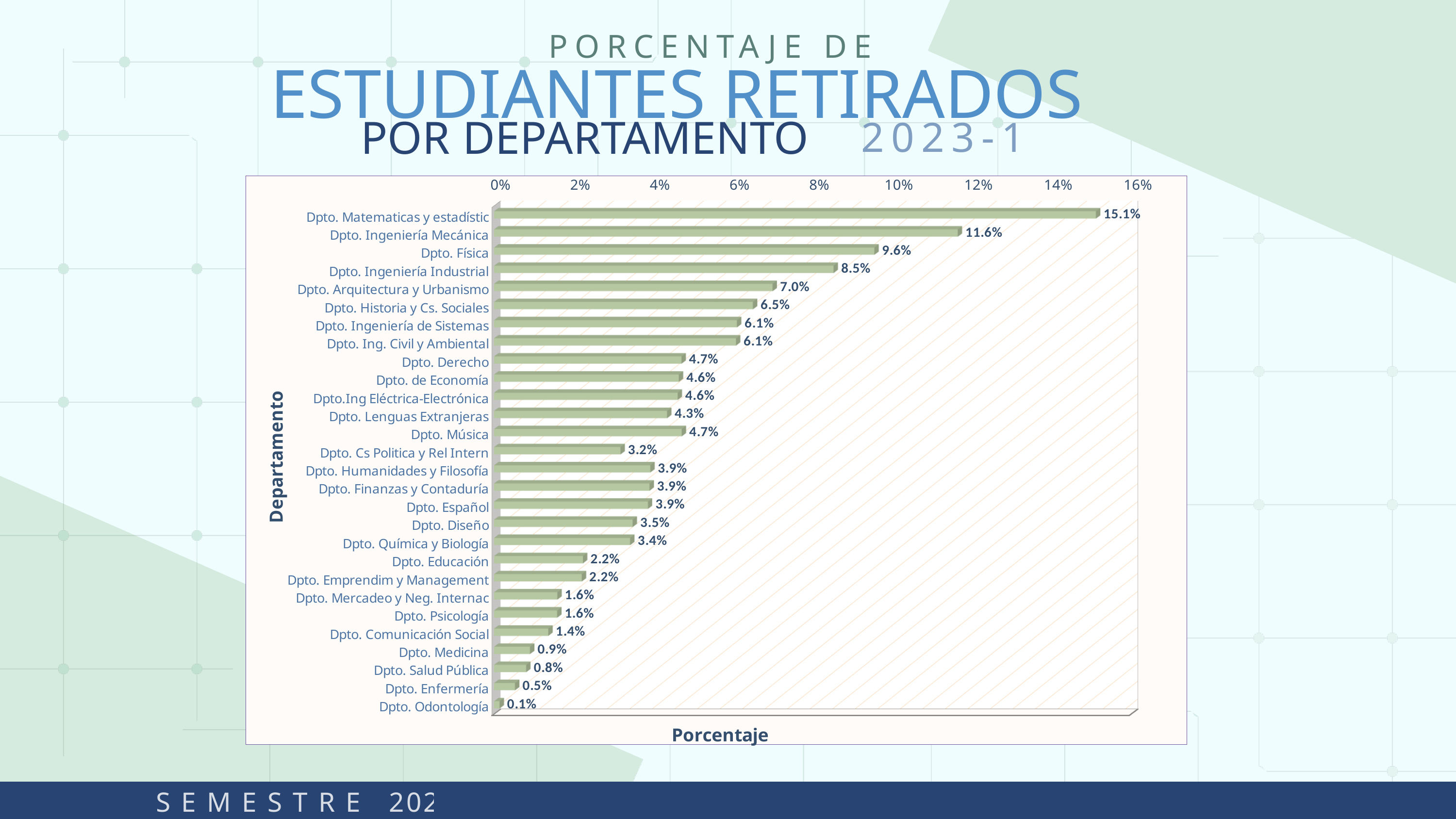
What kind of chart is shown on the slide? Bar chart Which department has the highest percentage of withdrawn students? Dpto. Matematicas y estadístic What is the difference between the values for Dpto. Arquitectura y Urbanismo and Dpto. Educación? 4.8% What is the label of the horizontal axis of the chart? Porcentaje What is the value for Dpto. Ingeniería Mecánica? 11.6% What is the difference between the values for Dpto. Matematicas y estadístic and Dpto. Ingeniería Mecánica? 3.5% What is the value for Dpto. Comunicación Social? 1.4% How many departments are shown in the chart? 28 Which department has the lowest percentage of withdrawn students? Dpto. Odontología Which is larger, the value for Dpto. Ingeniería Industrial or the value for Dpto. Historia y Cs. Sociales? Dpto. Ingeniería Industrial What is the value for Dpto. Física? 9.6% What is the value for Dpto. Química y Biología? 3.4%